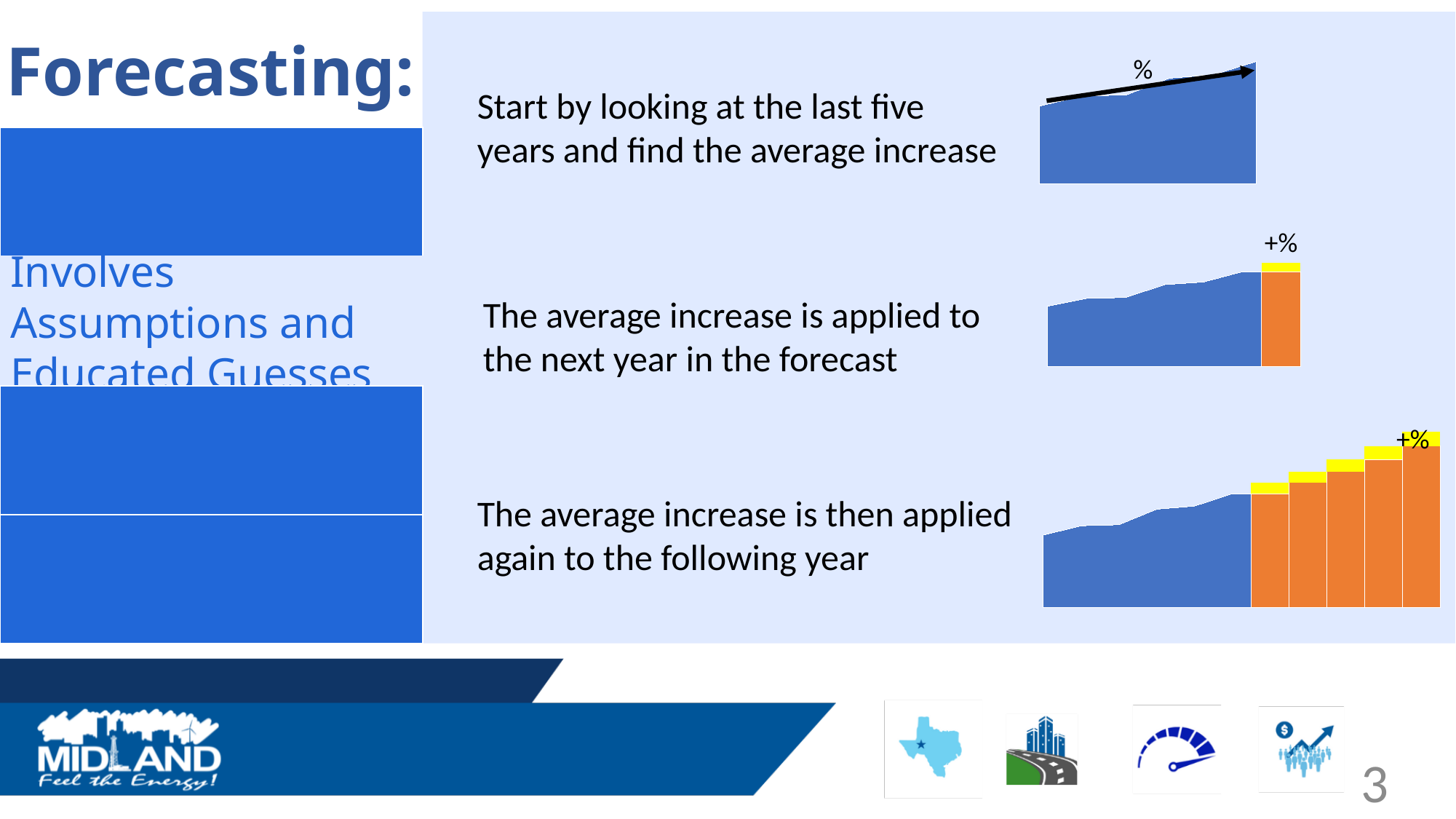
In the bottom chart, how many orange bars are shown? 5 In the bottom chart, what colour are the caps on top of the orange bars? yellow In the bottom chart, do the orange bars rise or fall from left to right? rise What label is printed above the orange bar in the middle chart? +% In the top chart, does the blue area rise or fall from left to right? rise What label is printed above the arrow in the top chart? % In the middle chart, how many orange bars are shown? 1